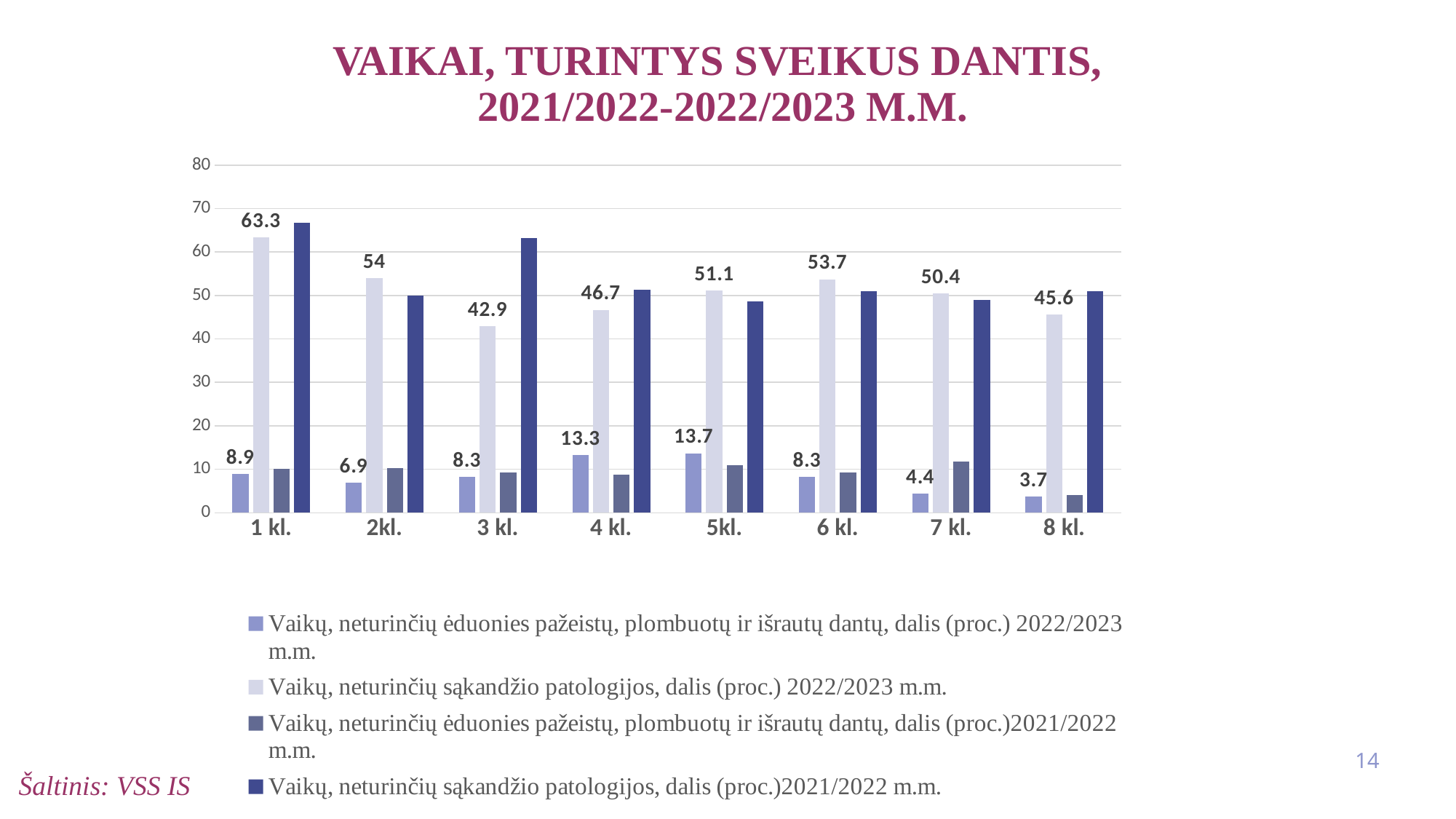
What is the value for 7 kl. in the series 'Vaikų, neturinčių sąkandžio patologijos, dalis (proc.) 2022/2023 m.m.'? 50.4 What is the difference between the 1 kl. and 8 kl. values in the series 'Vaikų, neturinčių sąkandžio patologijos, dalis (proc.) 2022/2023 m.m.'? 17.7 What is the value for 1 kl. in the series 'Vaikų, neturinčių sąkandžio patologijos, dalis (proc.) 2022/2023 m.m.'? 63.3 What kind of chart is shown on the slide? bar chart What is the value for 5kl. in the series 'Vaikų, neturinčių ėduonies pažeistų, plombuotų ir išrautų dantų, dalis (proc.) 2022/2023 m.m.'? 13.7 Is the value for 1 kl. in the series 'Vaikų, neturinčių sąkandžio patologijos, dalis (proc.)2021/2022 m.m.' greater or less than 60? greater How many series does the legend list? 4 Which class has the highest value in the series 'Vaikų, neturinčių sąkandžio patologijos, dalis (proc.) 2022/2023 m.m.'? 1 kl. Do the values in the series 'Vaikų, neturinčių sąkandžio patologijos, dalis (proc.) 2022/2023 m.m.' rise or fall from 1 kl. to 3 kl.? fall How many classes (categories) are shown on the x axis? 8 In the series 'Vaikų, neturinčių ėduonies pažeistų, plombuotų ir išrautų dantų, dalis (proc.) 2022/2023 m.m.', which is larger: 4 kl. or 5kl.? 5kl. Which class has the lowest value in the series 'Vaikų, neturinčių ėduonies pažeistų, plombuotų ir išrautų dantų, dalis (proc.) 2022/2023 m.m.'? 8 kl.